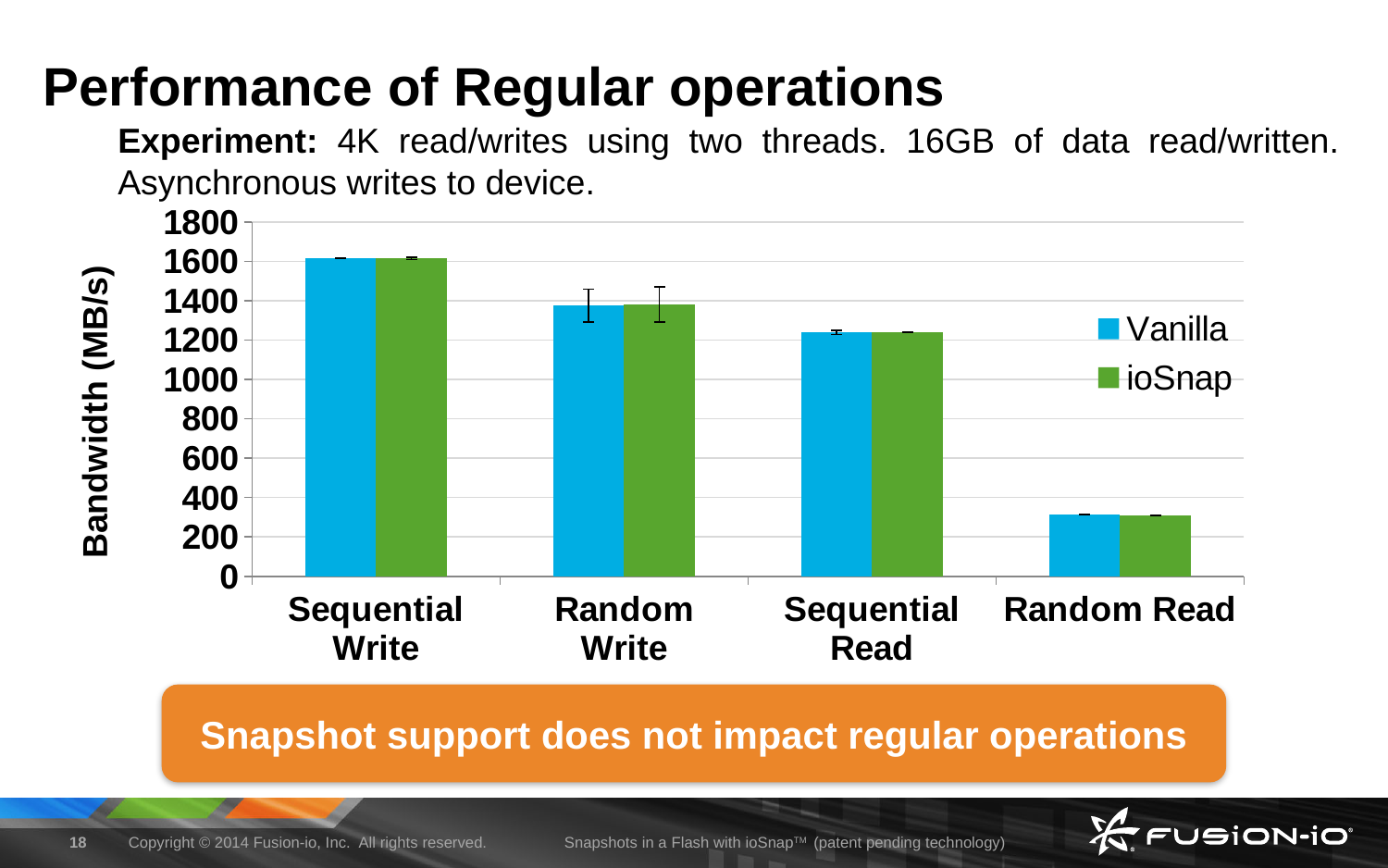
Is the ioSnap value for Random Read greater or less than 400? less How many series does the legend list? 2 Which category has the lowest bandwidth? Random Read Is the Vanilla value for Sequential Read greater or less than 1000? greater What kind of chart is shown on the slide? Bar chart How many categories are shown on the x axis? 4 Is the Vanilla value for Sequential Write greater or less than 1400? greater Do the bandwidth values rise or fall moving from left to right along the x axis? fall Which has a higher ioSnap bandwidth, Sequential Read or Random Read? Sequential Read Which has a higher Vanilla bandwidth, Sequential Write or Random Write? Sequential Write Which category has the highest bandwidth? Sequential Write What is the label on the y axis of the chart? Bandwidth (MB/s)